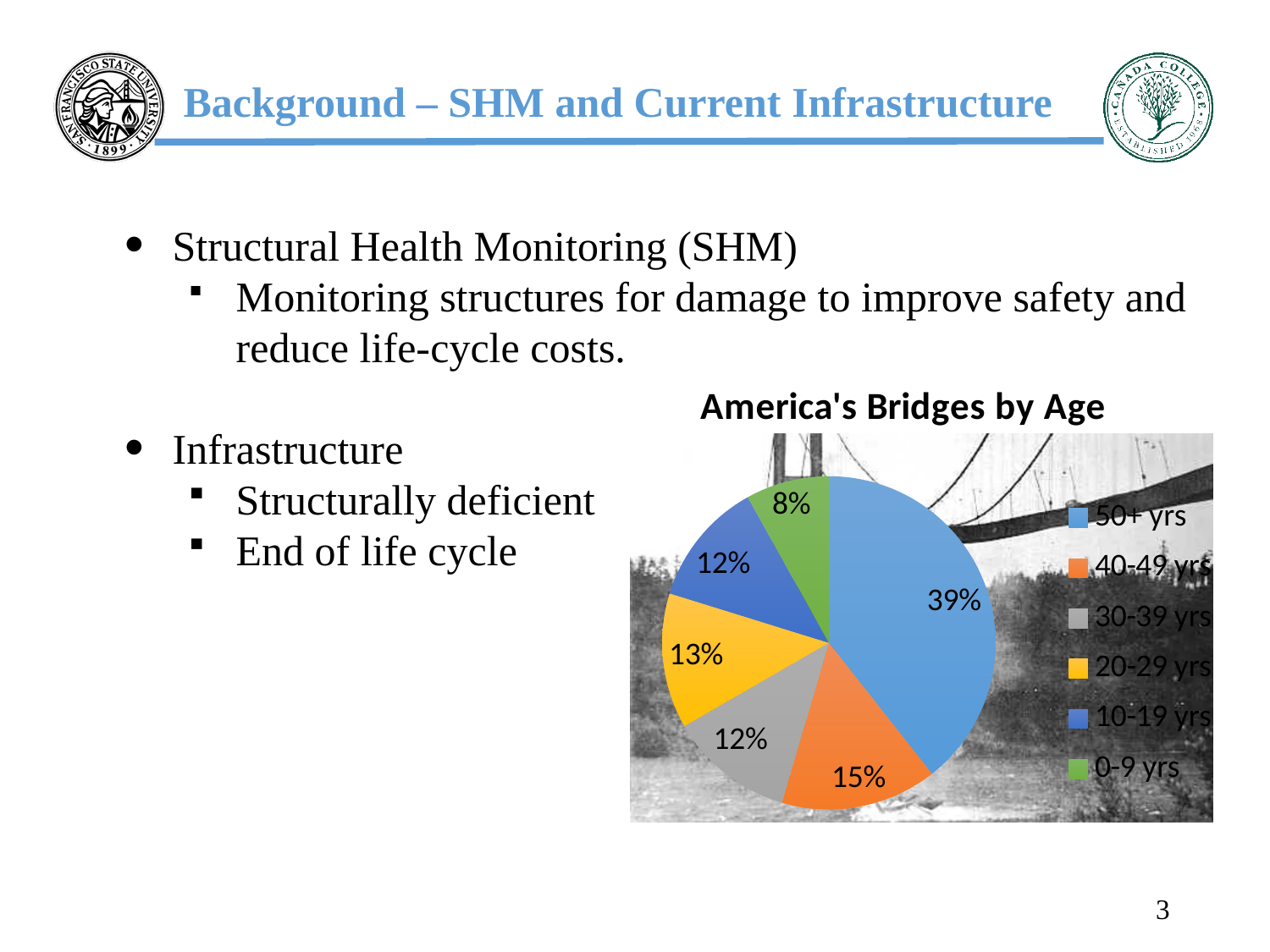
What share of America's bridges are 20-29 yrs old? 13% What is the difference between the share of bridges aged 50+ yrs and those aged 40-49 yrs? 24% What share of America's bridges are 50+ yrs old? 39% Which age group has the largest share of America's bridges? 50+ yrs What type of chart is shown on the slide? pie chart What share of America's bridges are 0-9 yrs old? 8% What share of America's bridges are 40-49 yrs old? 15% Which is larger: the share of bridges aged 20-29 yrs or the share aged 0-9 yrs? 20-29 yrs What colour is the slice for bridges aged 0-9 yrs? green What is the title of the chart? America's Bridges by Age How many age categories does the pie chart show? 6 Which age group has the smallest share of America's bridges? 0-9 yrs